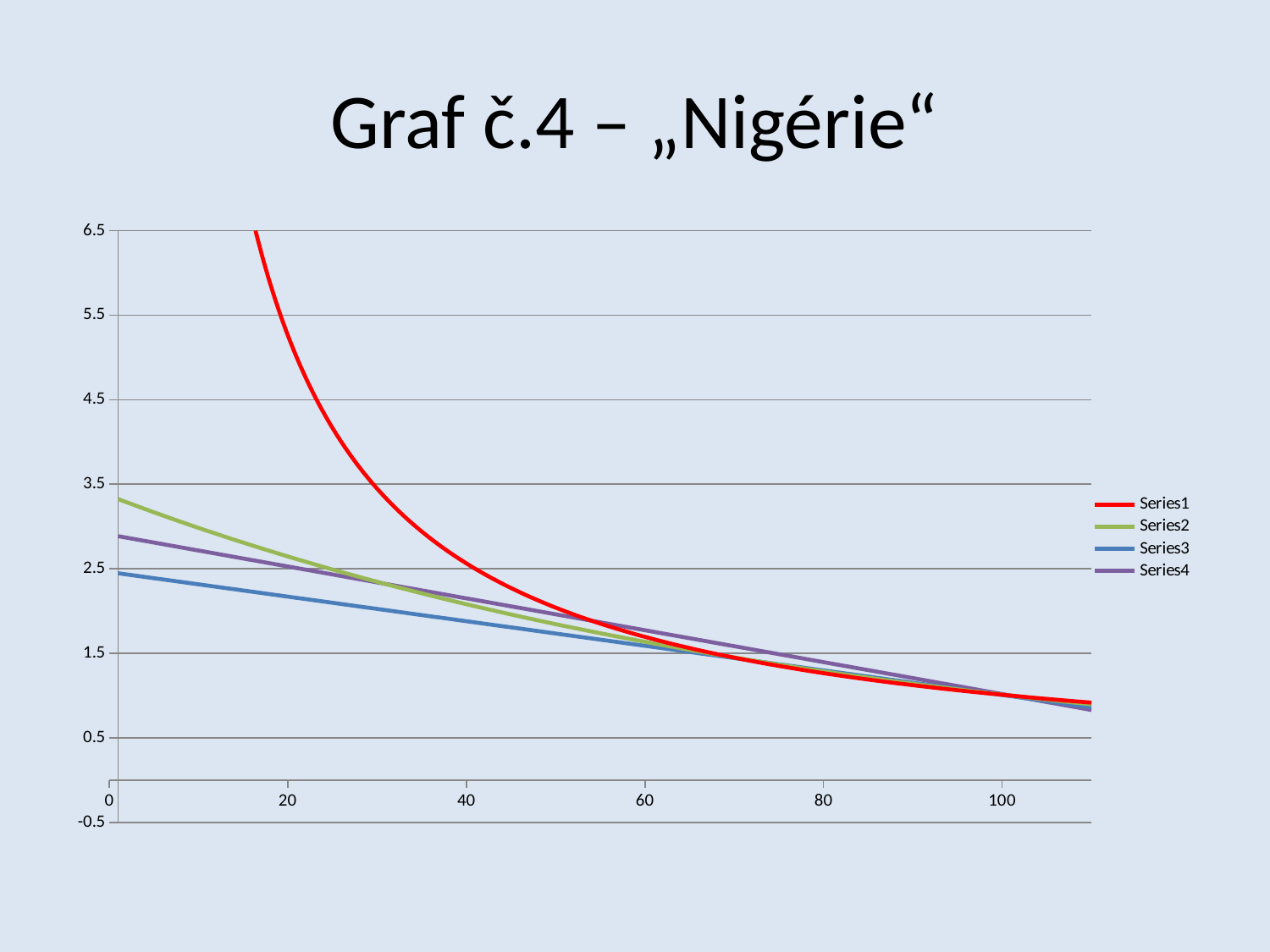
At x = 0, which is larger: Series2 or Series3? Series2 Do the values of Series3 rise or fall as x increases? fall Which colour is used for Series1? red Is the value of Series1 at x = 20 greater or less than 4.5? greater Do the values of Series1 rise or fall as x increases? fall Is the value of Series3 at x = 40 greater or less than 1.5? greater How many series does the legend list? 4 What kind of chart is shown on the slide? line chart Is the value of Series4 at x = 100 greater or less than 1.5? less What is the title of the chart? Graf č.4 – „Nigérie“ Which series has the highest value at x = 20? Series1